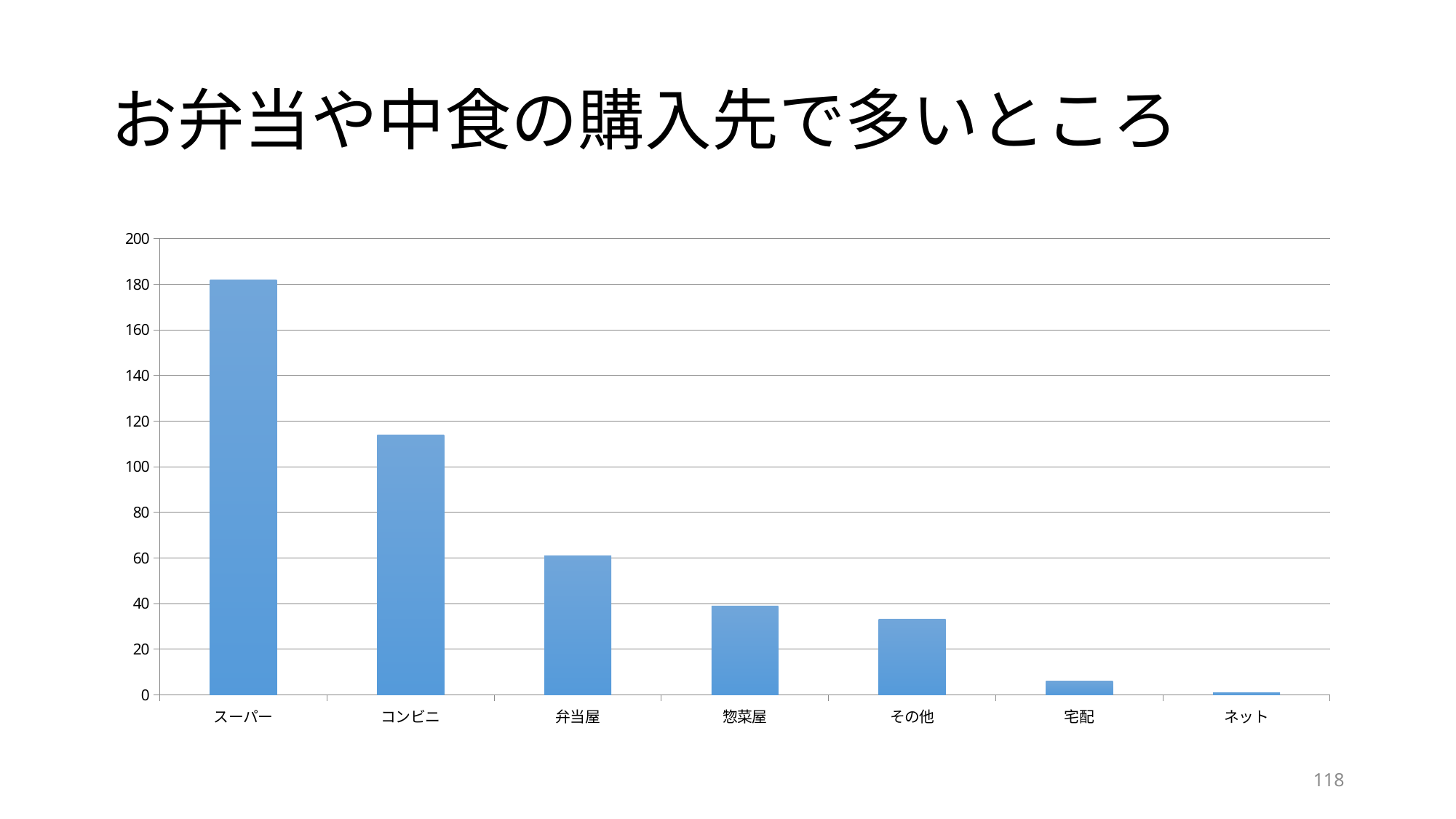
Is the value for 惣菜屋 greater or less than 20? greater What is the title of the slide containing the chart? お弁当や中食の購入先で多いところ Is the value for 宅配 greater or less than 20? less How many categories are shown on the x axis? 7 Is the value for 弁当屋 greater or less than 80? less Do the values rise or fall from left to right along the x axis? fall What kind of chart is shown on the slide? bar chart Which category has the highest value? スーパー Which category has the lowest value? ネット Which is larger, the value for コンビニ or the value for 弁当屋? コンビニ